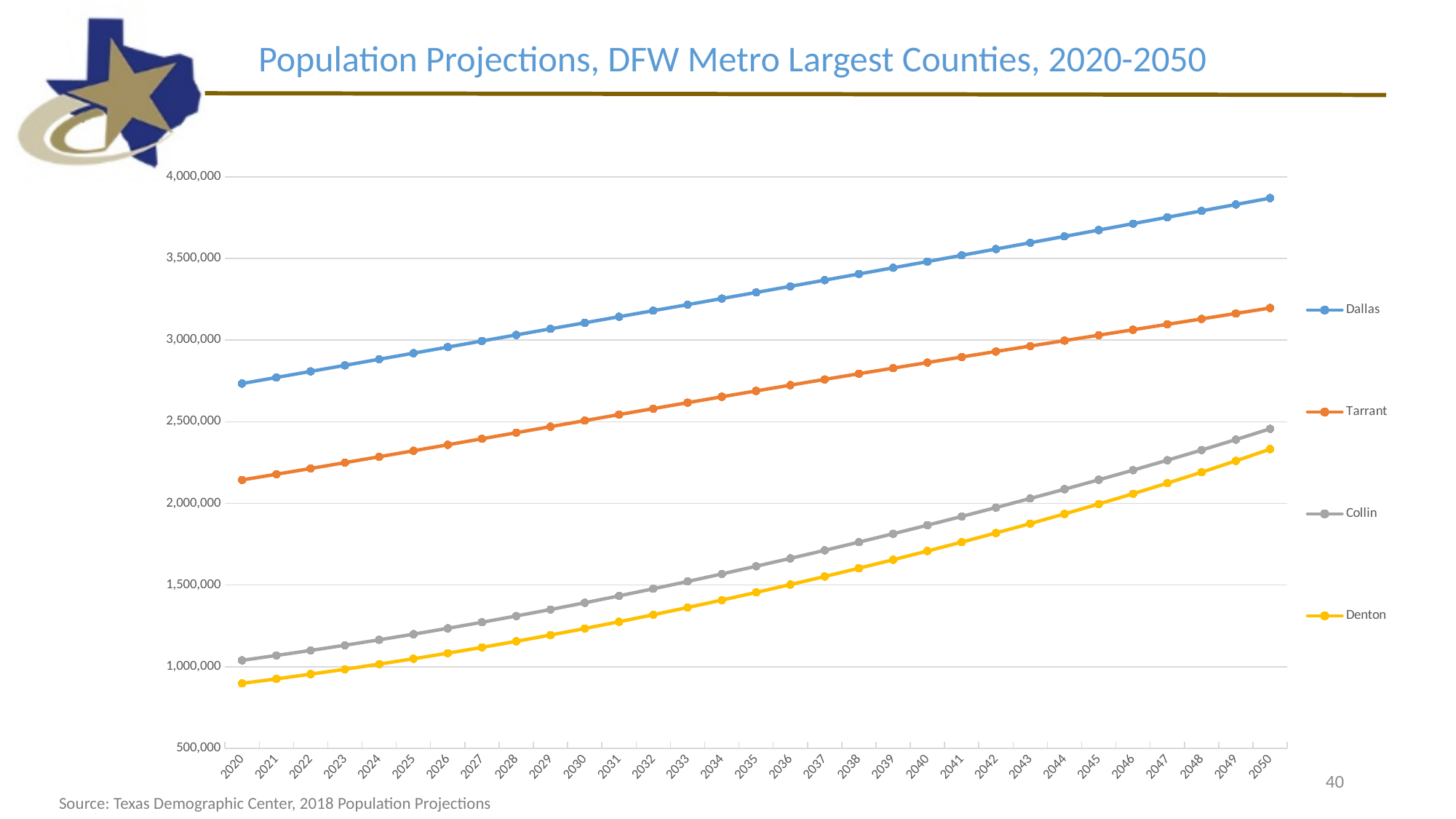
In 2050, which is larger, the value for Collin or the value for Denton? Collin Is the value for Dallas in 2020 greater or less than 3,000,000? less Which county has the lowest projected population in 2020? Denton Does the Dallas line rise or fall from 2020 to 2050? rises What is the title of the chart? Population Projections, DFW Metro Largest Counties, 2020-2050 Is the value for Collin in 2040 greater or less than 1,500,000? greater What kind of chart is shown on the slide? line chart How many series does the legend list? 4 Is the value for Tarrant in 2050 greater or less than 3,000,000? greater Which county has the highest projected population in 2050? Dallas How many years are plotted along the x axis? 31